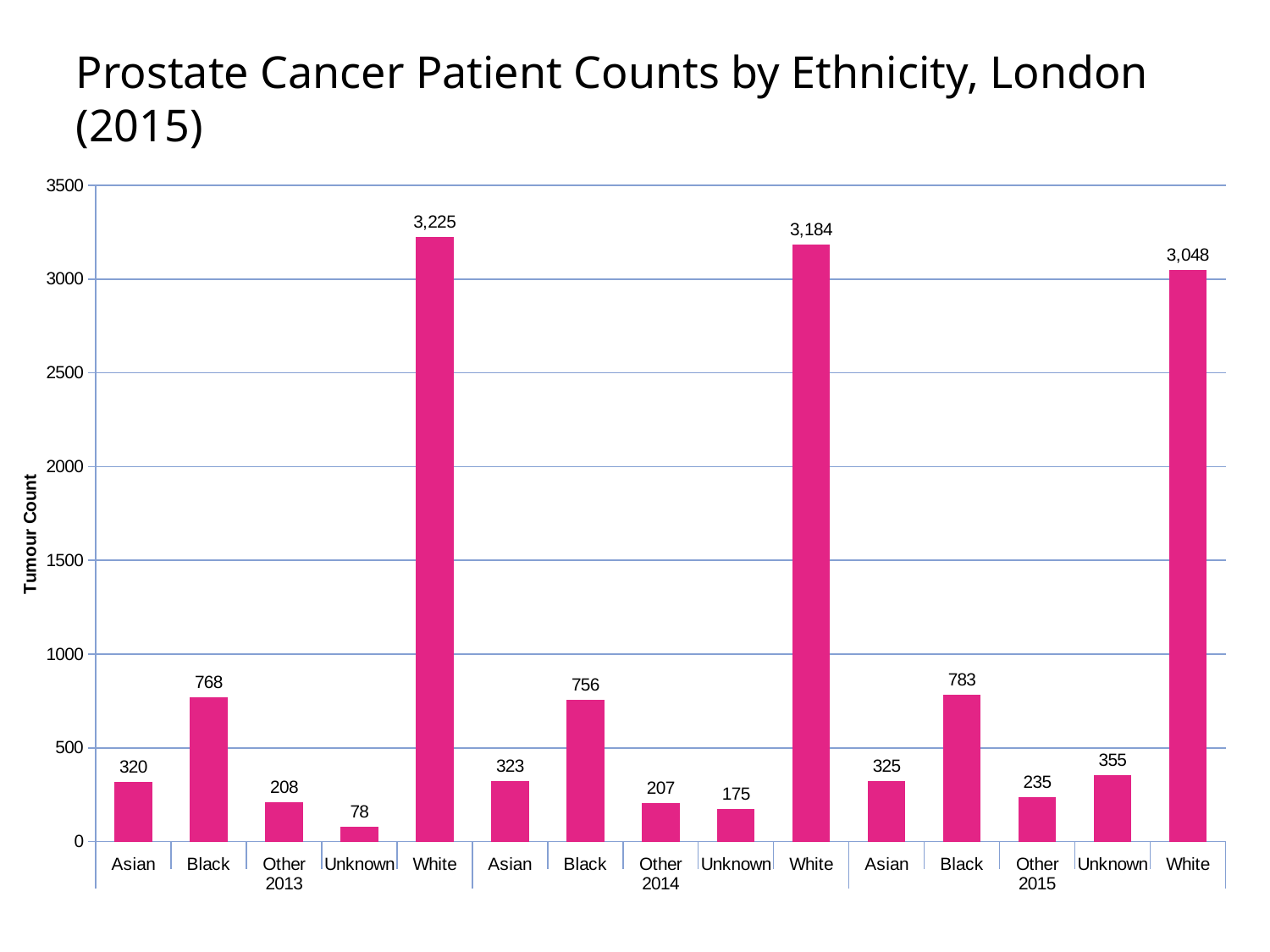
What is the difference between the White tumour counts in 2013 and 2015? 177 What is the tumour count for Black patients in 2015? 783 What kind of chart is shown on the slide? bar chart How many bars are plotted on the chart? 15 What is the label on the vertical axis of the chart? Tumour Count What is the tumour count for White patients in 2013? 3,225 Which is larger, the Black tumour count in 2013 or in 2014? 2013 What is the tumour count for Unknown ethnicity in 2014? 175 Which bar has the lowest tumour count on the whole chart? Unknown 2013 Does the tumour count for White patients rise or fall from 2013 to 2015? fall Is the tumour count for Unknown ethnicity in 2015 greater or less than 500? less Which ethnicity group has the highest tumour count in 2015? White